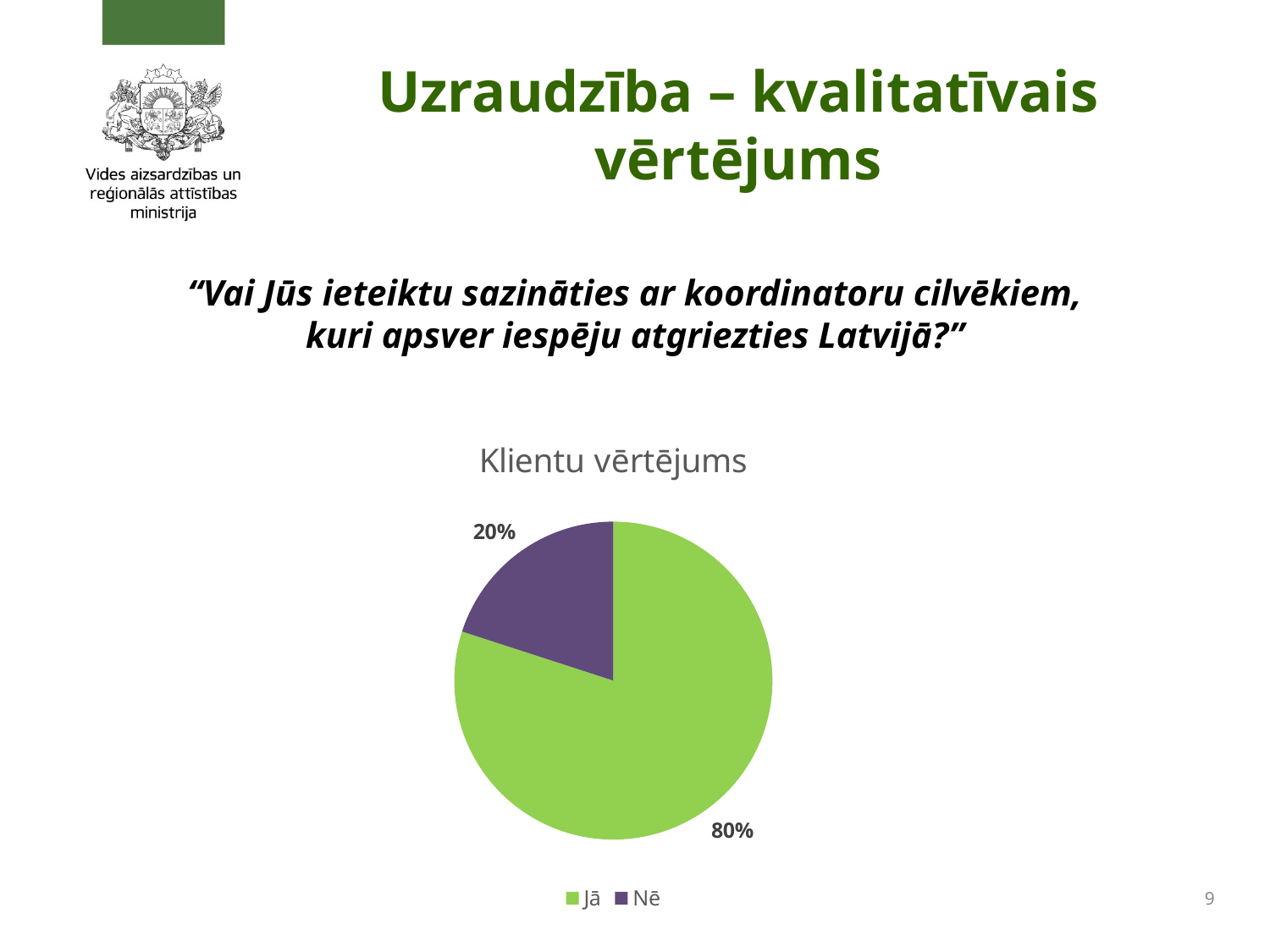
What is the difference in percentage points between the "Jā" and "Nē" slices? 60 percentage points Is the share for "Jā" greater or less than 50%? greater What kind of chart is shown on the slide? pie chart How many entries does the legend list? 2 What share of the pie does "Jā" represent? 80% Which is larger, the "Jā" slice or the "Nē" slice? Jā Which slice of the pie is the largest? Jā What colour is the "Nē" slice? purple How many slices does the pie chart have? 2 Which slice of the pie is the smallest? Nē What is the title of the chart? Klientu vērtējums What share of the pie does "Nē" represent? 20%